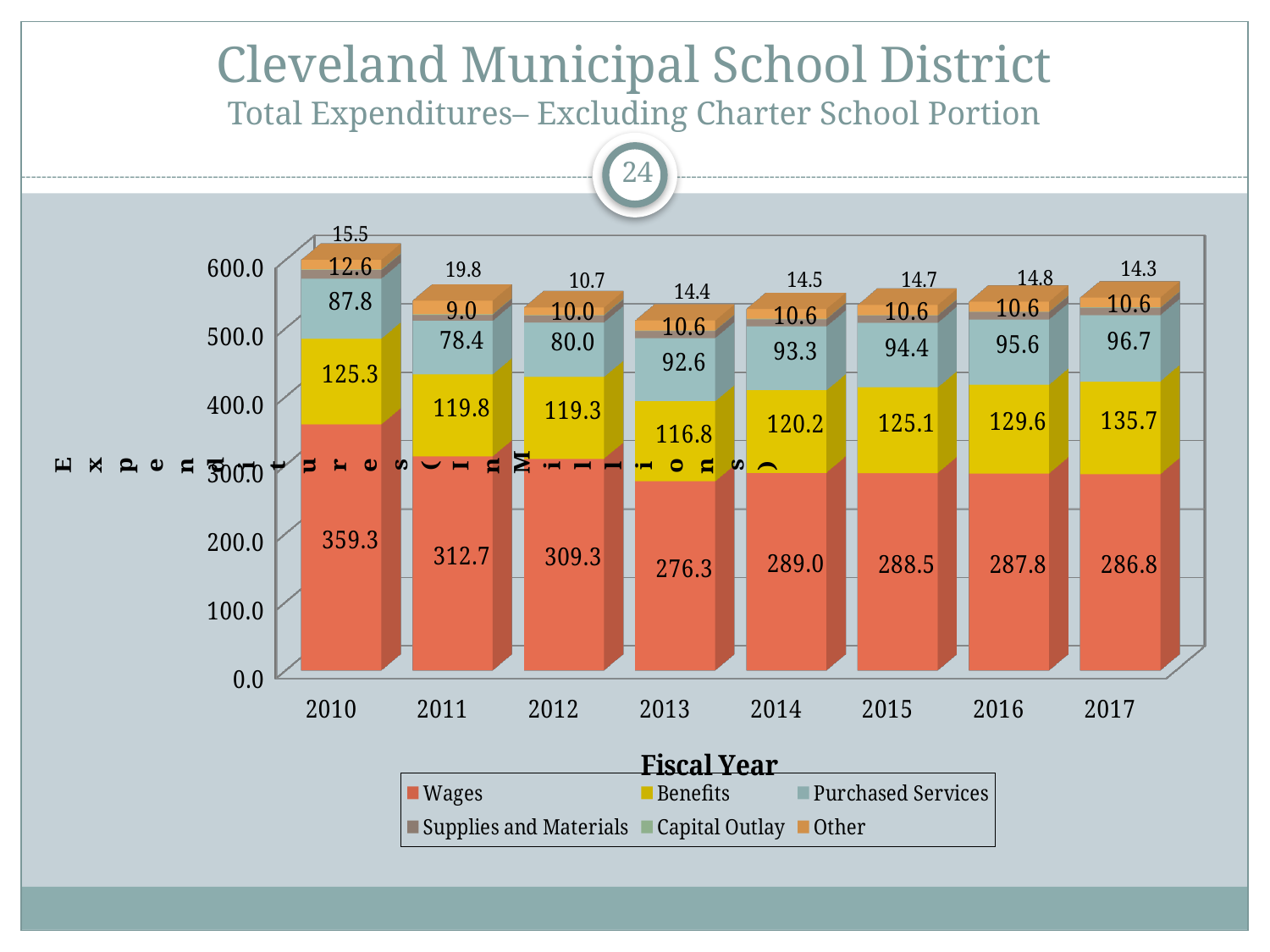
What is the Wages value for fiscal year 2010? 359.3 How many series does the legend list? 6 What is the Purchased Services value for fiscal year 2013? 92.6 In which fiscal year is the Wages value lowest? 2013 Which is larger, the Benefits value in 2016 or in 2015? 2016 What is the title of the x axis? Fiscal Year What is the difference between the Wages value in 2010 and in 2011? 46.6 What is the Benefits value for fiscal year 2017? 135.7 In which fiscal year is the Other value highest? 2011 How many fiscal years are shown on the x axis? 8 Do the Purchased Services values rise or fall from 2013 to 2017? Rise What kind of chart is shown on the slide? Stacked bar chart